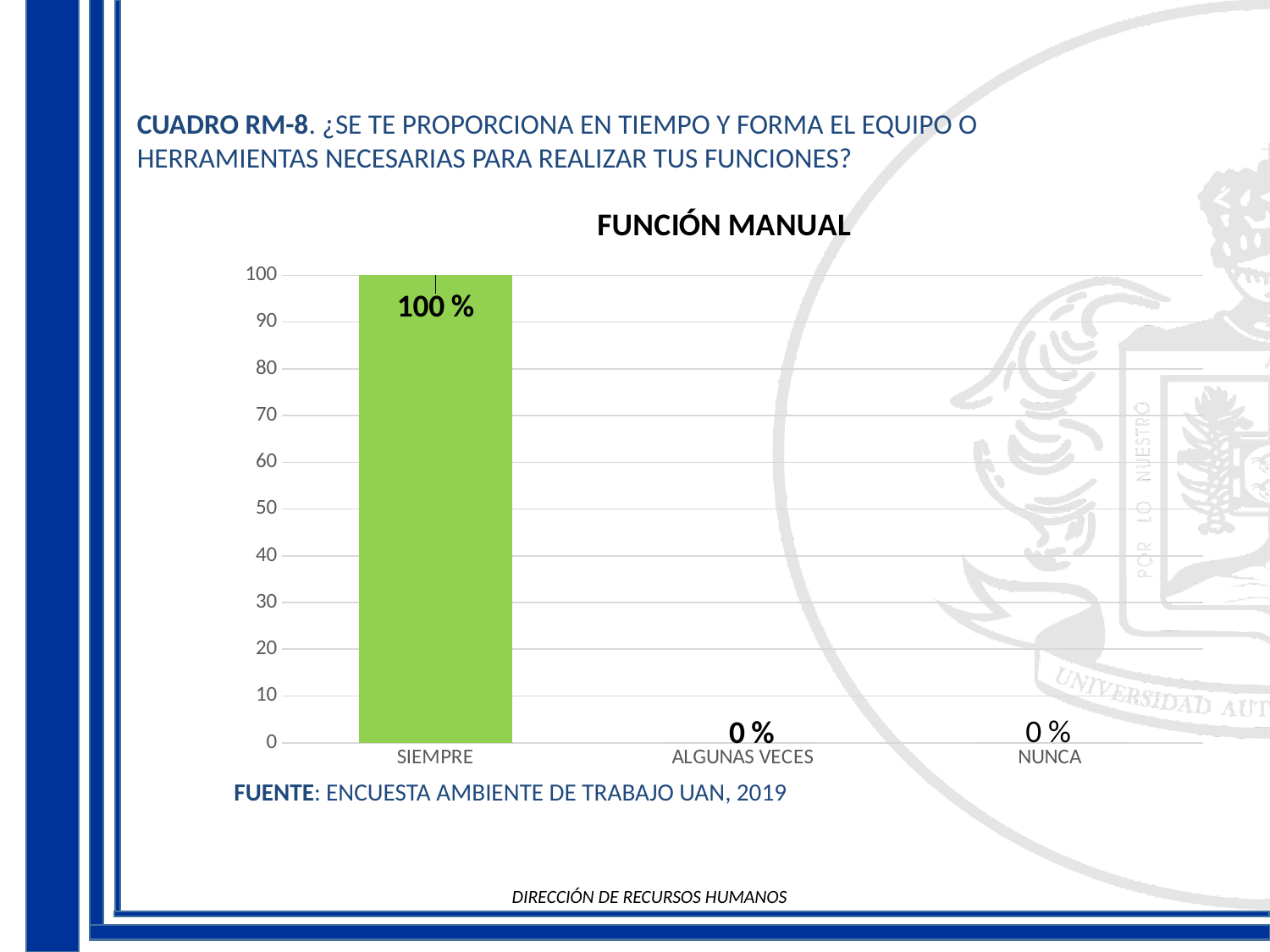
What is the value for ALGUNAS VECES? 0 % What is the value for NUNCA? 0 % Do the values rise or fall from SIEMPRE to NUNCA along the x axis? fall What is the title of the chart? FUNCIÓN MANUAL What is the difference between the values for SIEMPRE and ALGUNAS VECES? 100 % Which is larger, the value for SIEMPRE or the value for NUNCA? SIEMPRE What colour is the bar for SIEMPRE? green Which category has the highest value? SIEMPRE How many categories are shown on the x axis? 3 Is the value for SIEMPRE greater or less than 50? greater What kind of chart is shown? bar chart What is the value for SIEMPRE? 100 %